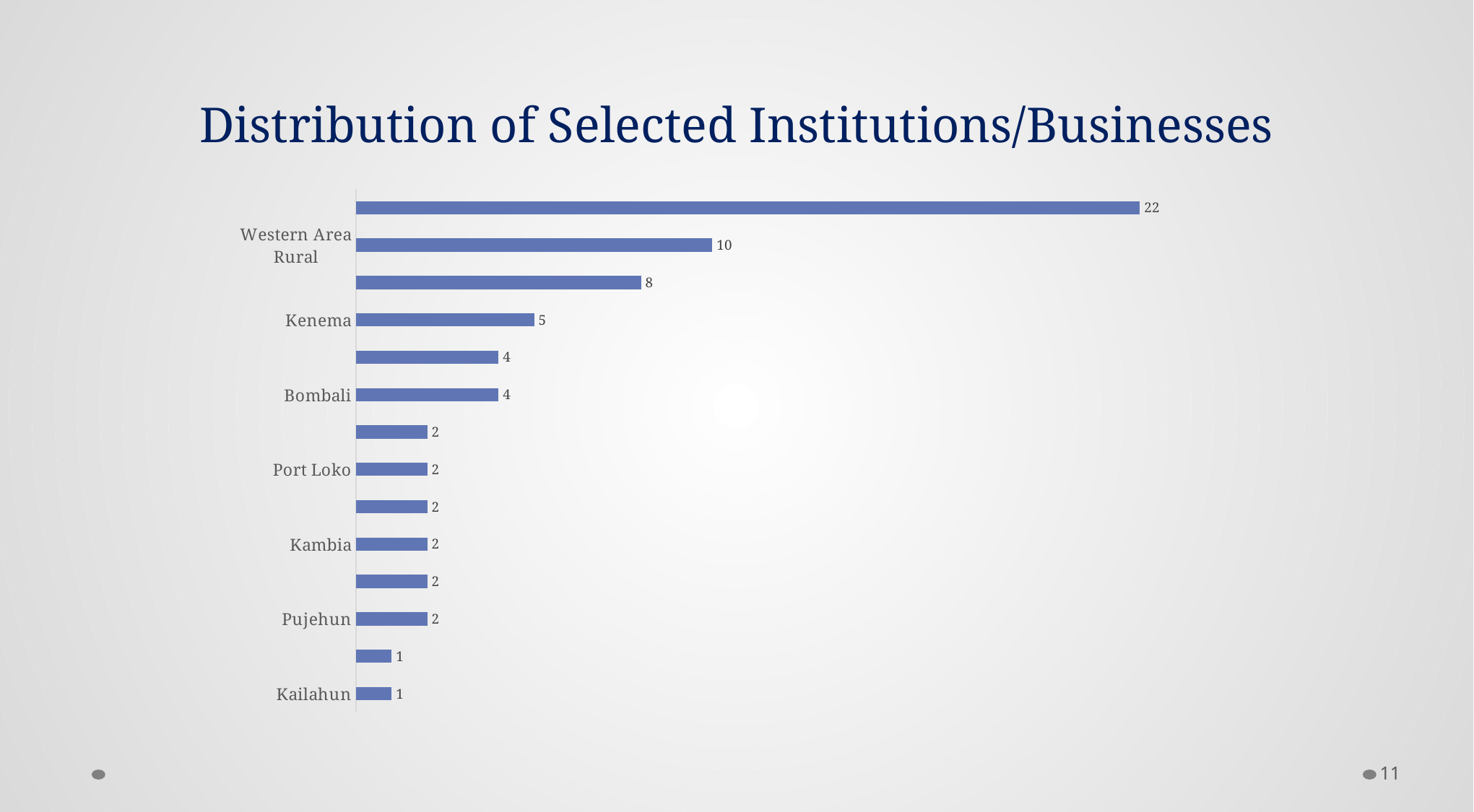
What kind of chart is shown on the slide? Bar chart What is the value for Western Area Rural? 10 What is the largest value shown on any bar in the chart? 22 Which has a larger value, Kenema or Pujehun? Kenema What is the value for Bombali? 4 What is the value for Kailahun? 1 What is the value for Port Loko? 2 How many bars are plotted in the chart? 14 What is the value for Kenema? 5 What is the difference between the values for Western Area Rural and Kenema? 5 What is the difference between the values for Kenema and Bombali? 1 What is the title of the chart? Distribution of Selected Institutions/Businesses